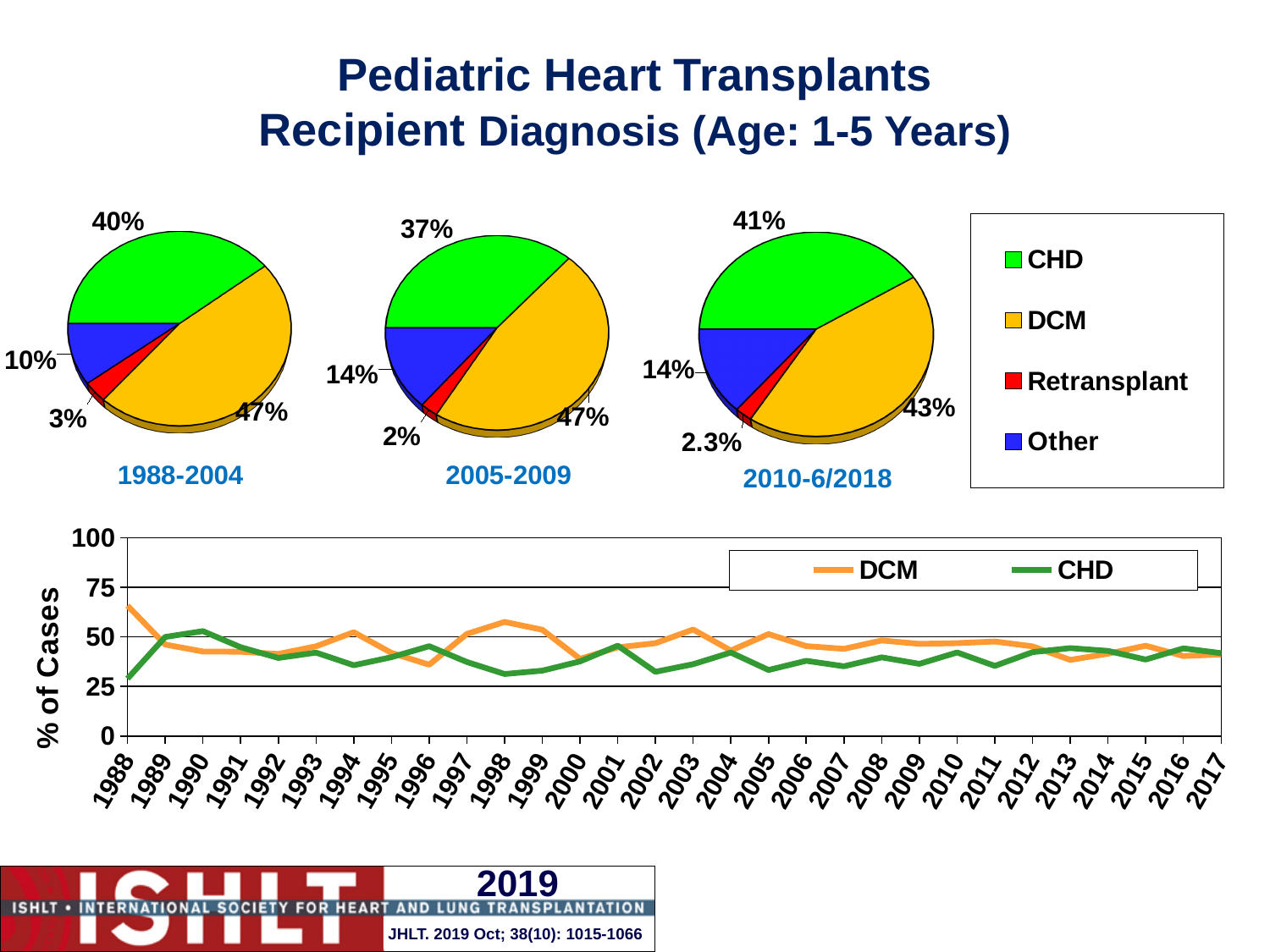
What kind of chart is the bottom chart showing % of Cases by year? Line chart In the 1988-2004 pie chart, what share of cases is DCM? 47% In the 1988-2004 pie chart, which diagnosis has the smallest share? Retransplant How many series does the legend of the bottom line chart list? 2 In the 1988-2004 pie chart, which is larger, the Other share or the Retransplant share? Other In the bottom line chart, is the CHD value for 1988 greater or less than 50? less In the 2005-2009 pie chart, what is the difference between the DCM share and the CHD share? 10% In the 2010-6/2018 pie chart, what share of cases is Retransplant? 2.3% In the 2005-2009 pie chart, what share of cases is CHD? 37% In the bottom line chart, is the DCM value for 1988 greater or less than 50? greater In the 2010-6/2018 pie chart, which diagnosis has the largest share? DCM How many series does the legend of the pie charts list? 4